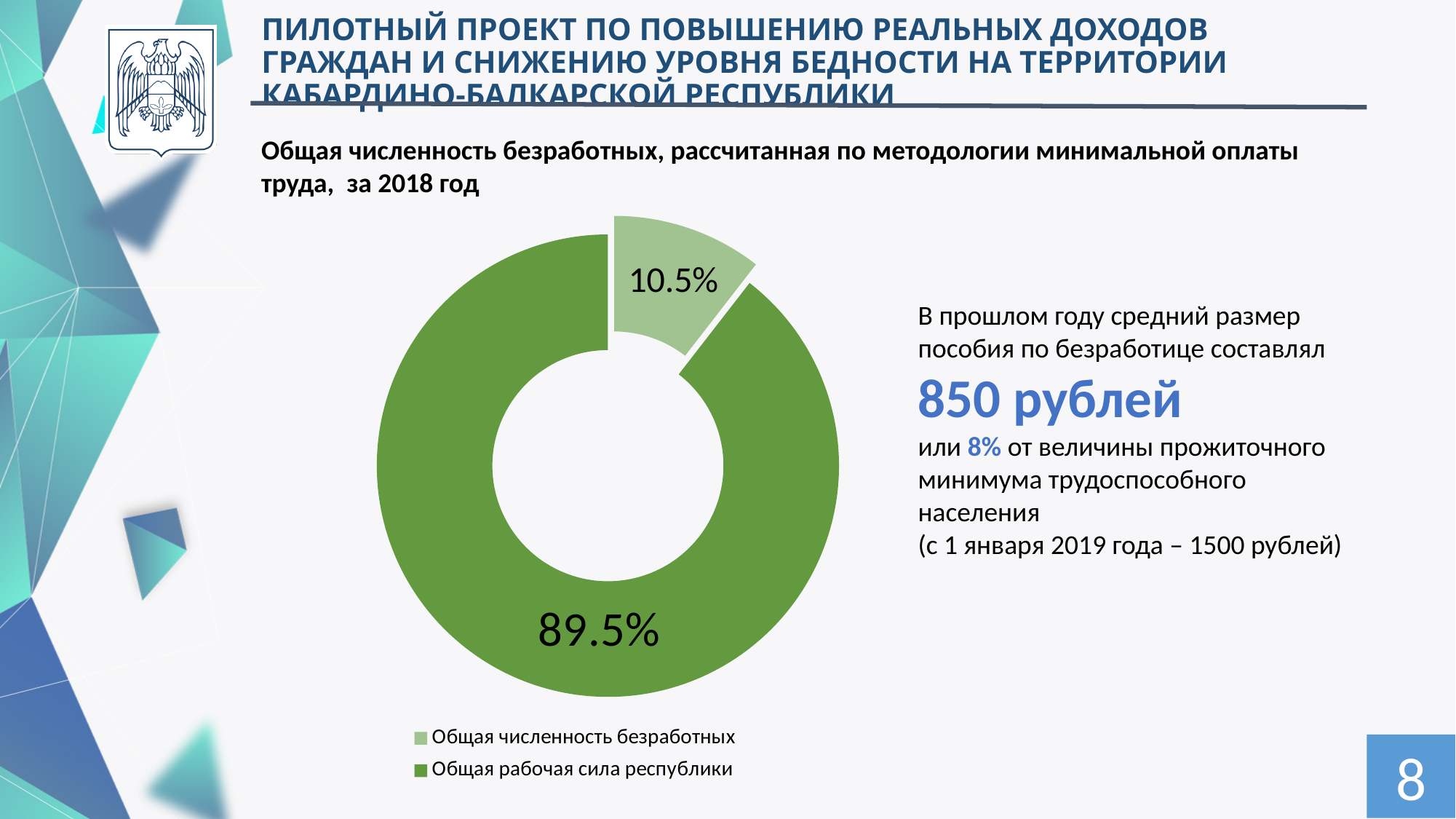
How many entries does the chart legend list? 2 Which slice of the chart is the largest? Общая рабочая сила республики For which year does the chart show the total number of unemployed? 2018 Which is larger: the slice for "Общая численность безработных" or the slice for "Общая рабочая сила республики"? Общая рабочая сила республики What share of the doughnut chart is labelled "Общая рабочая сила республики"? 89.5% What kind of chart is shown on the slide? Doughnut (pie) chart How many slices does the chart have? 2 Which colour represents "Общая численность безработных" in the chart? Light green What is the total of the two percentages shown on the chart? 100% Which slice of the chart is the smallest? Общая численность безработных What is the difference in percentage points between the two slices of the chart? 79 What share of the doughnut chart is labelled "Общая численность безработных"? 10.5%